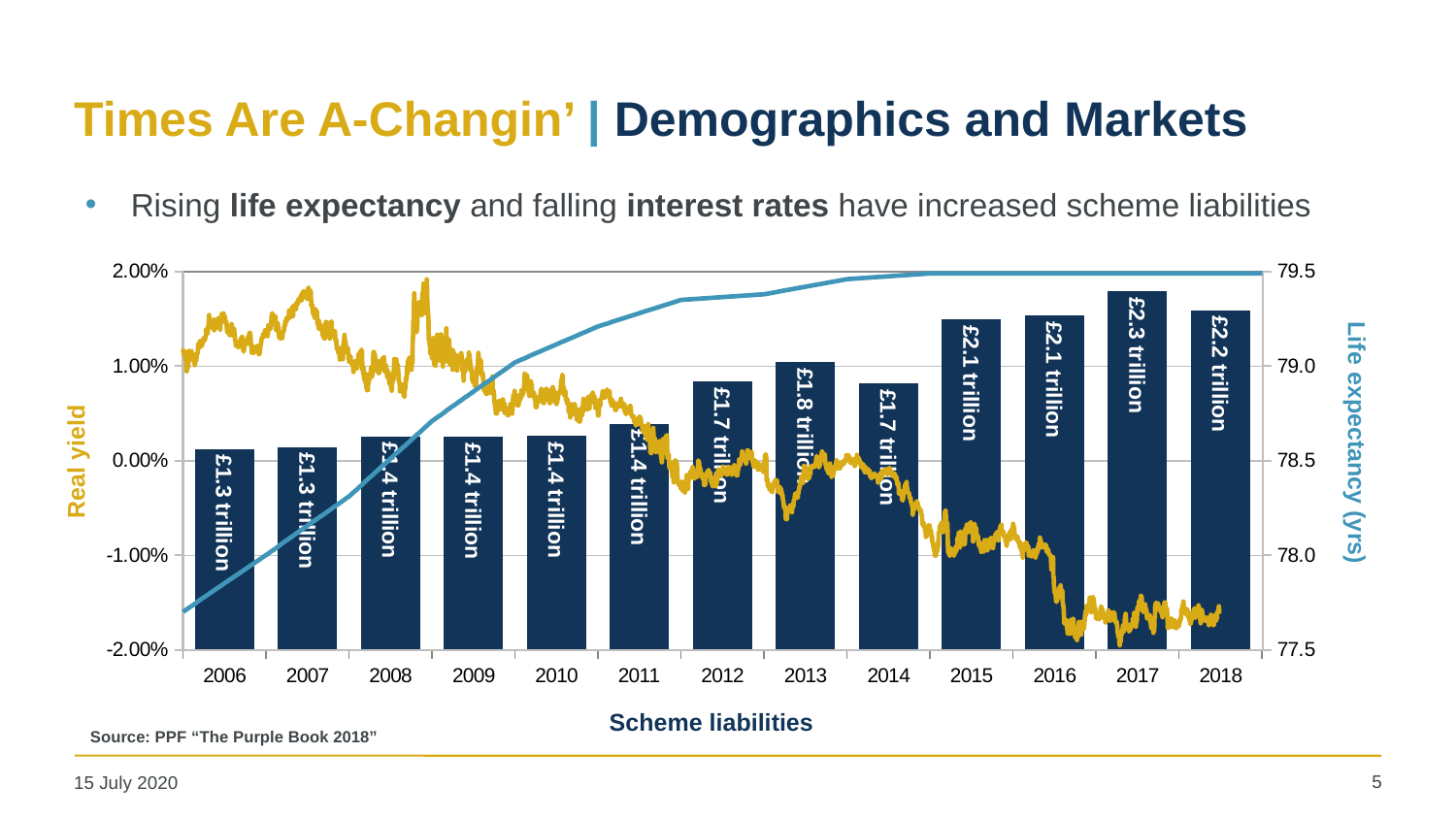
What is the value of scheme liabilities shown for 2017? £2.3 trillion Does the life expectancy line rise or fall from 2006 to 2018? rise What is the difference between scheme liabilities in 2018 and 2006? £0.9 trillion Which year has the highest scheme liabilities? 2017 Does the real yield line generally rise or fall from 2006 to 2018? fall Is the real yield at the end of 2018 greater or less than -1.00%? less What is the value of scheme liabilities shown for 2006? £1.3 trillion What is the lowest scheme liabilities value shown on the bars? £1.3 trillion Which year has larger scheme liabilities, 2014 or 2015? 2015 What kind of chart is used to show scheme liabilities? bar chart What is the value of scheme liabilities shown for 2013? £1.8 trillion How many years of scheme liabilities bars are shown? 13